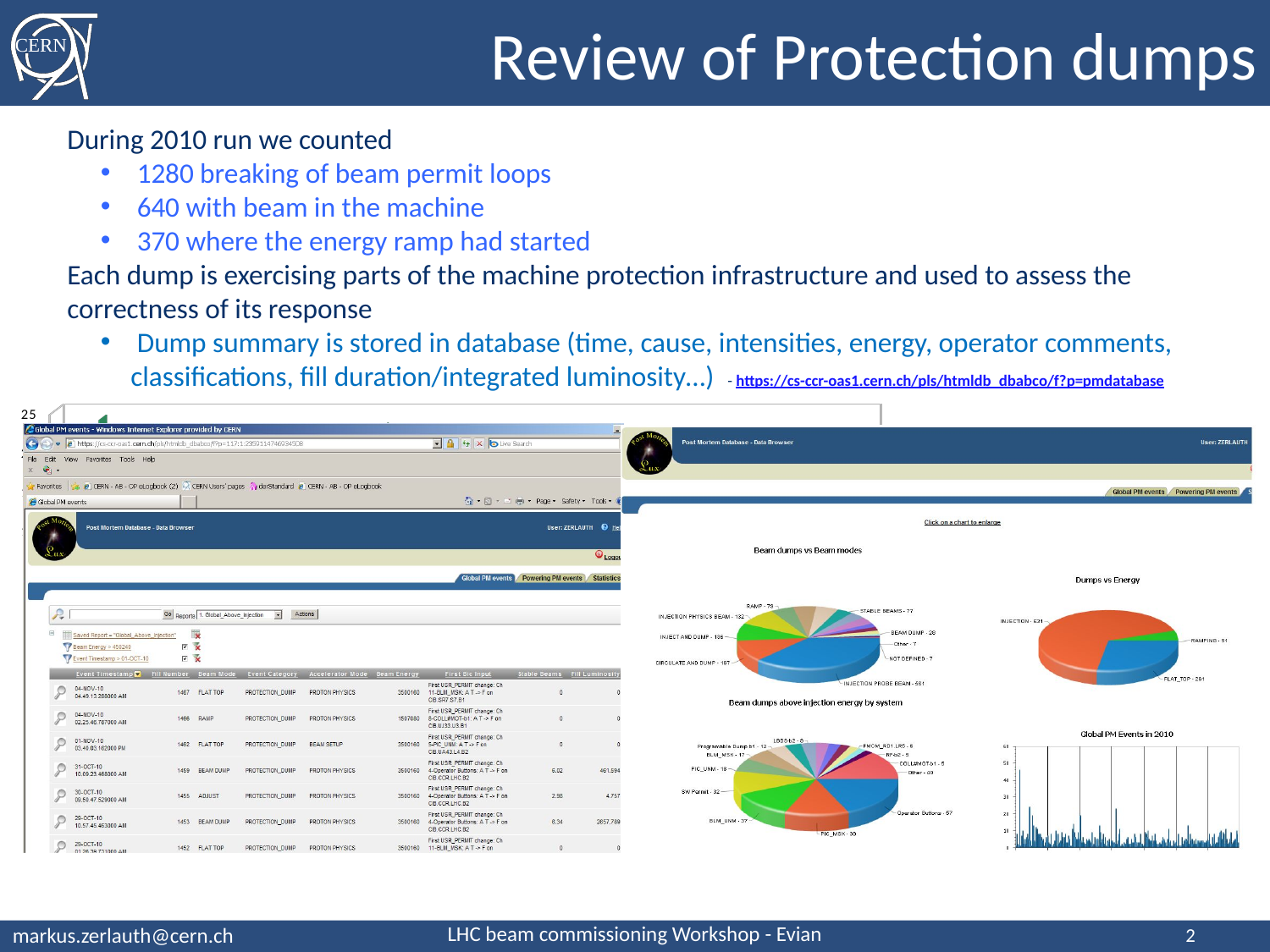
In the 'Dumps vs Energy' pie chart, which category has the largest slice? INJECTION In the 'Dumps vs Energy' pie chart, how many dumps are attributed to RAMPING? 51 In the 'Beam dumps vs Beam modes' pie chart, which beam mode has the largest slice? INJECTION PROBE BEAM In the 'Dumps vs Energy' pie chart, how many categories are shown? 3 In the 'Dumps vs Energy' pie chart, what is the difference between the INJECTION and FLAT_TOP values? 540 What kind of chart is 'Global PM Events in 2010'? bar chart In the 'Beam dumps vs Beam modes' pie chart, how many dumps are attributed to INJECTION PROBE BEAM? 561 In the 'Dumps vs Energy' pie chart, how many dumps are attributed to FLAT_TOP? 281 In the 'Dumps vs Energy' pie chart, which category has the smallest slice? RAMPING In the 'Dumps vs Energy' pie chart, how many dumps are attributed to INJECTION? 821 In the 'Beam dumps above injection energy by system' pie chart, how many dumps are attributed to Operator Buttons? 57 In the 'Beam dumps vs Beam modes' pie chart, which is larger, CIRCULATE AND DUMP or INJECT AND DUMP? CIRCULATE AND DUMP